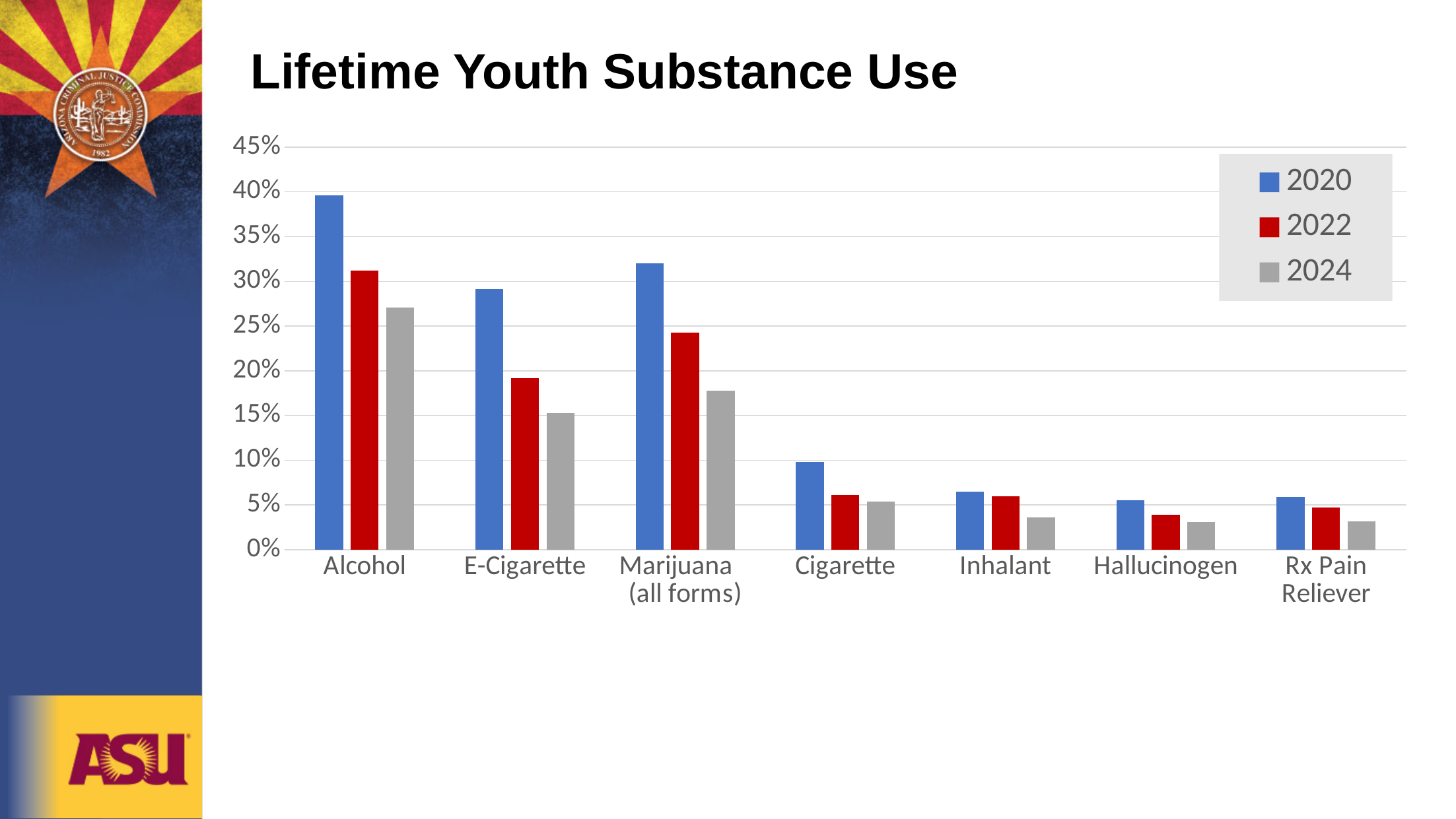
How many substance categories are shown on the x axis? 7 Is the 2024 value for Marijuana (all forms) greater or less than 20%? less Do the Alcohol values rise or fall from 2020 to 2024? fall Is the 2020 value for Alcohol greater or less than 35%? greater What kind of chart is shown on the slide? Bar chart How many series does the legend list? 3 Which is larger, the 2020 value for Marijuana (all forms) or the 2020 value for E-Cigarette? Marijuana (all forms) Which substance has the highest 2024 value? Alcohol Which is larger, the 2020 value for Cigarette or the 2020 value for Inhalant? Cigarette What colour represents the 2022 series in the legend? Red Which substance has the highest 2020 value? Alcohol